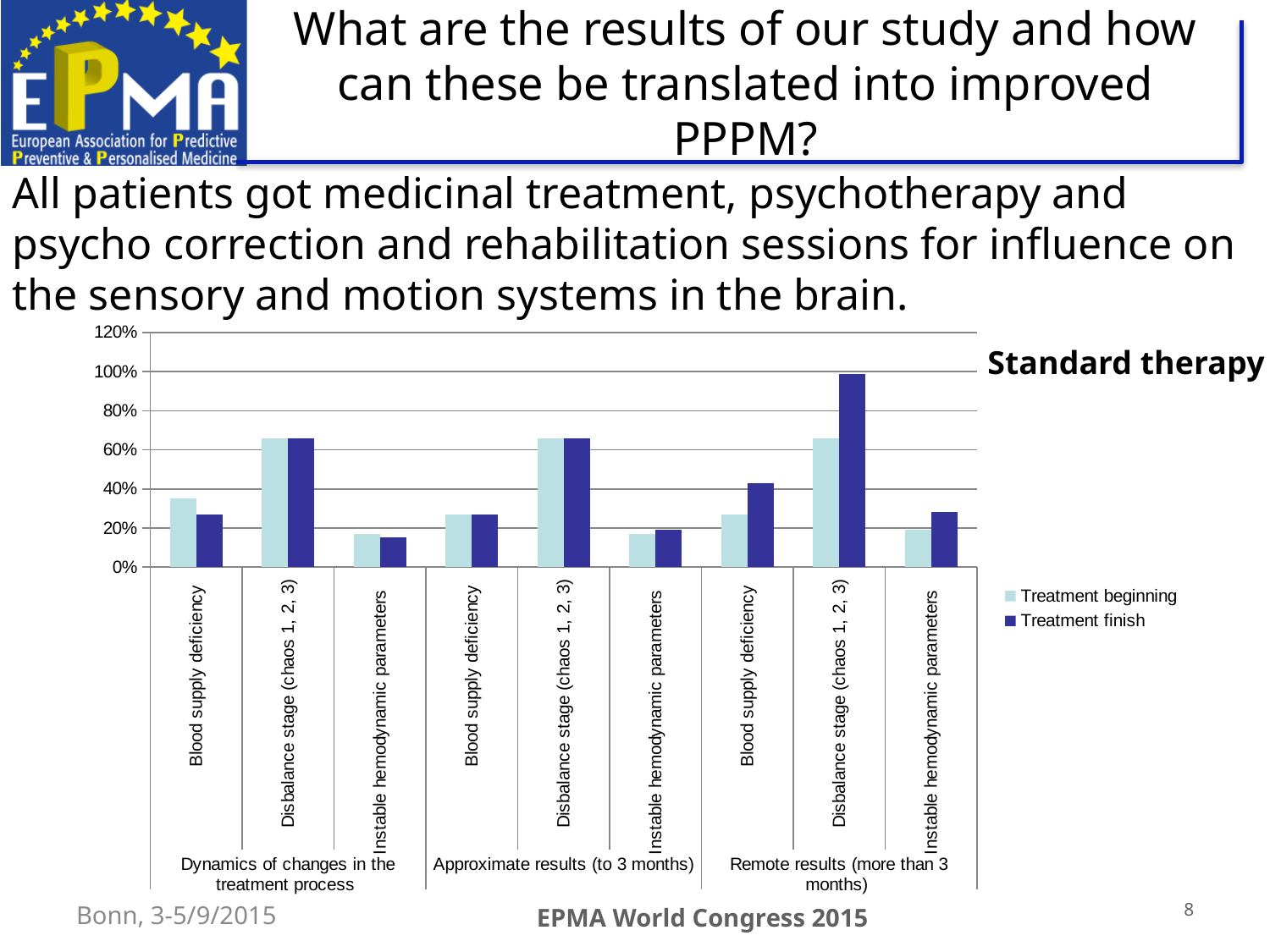
Is the Treatment beginning value for Disbalance stage (chaos 1, 2, 3) under Approximate results (to 3 months) greater or less than 60%? greater Is the Treatment beginning value for Blood supply deficiency under Dynamics of changes in the treatment process greater or less than 40%? less What label appears in bold to the right of the chart, above the legend? Standard therapy How many category bars groups (x-axis categories) are plotted in the chart? 9 Is the Treatment beginning value for Instable hemodynamic parameters under Dynamics of changes in the treatment process greater or less than 20%? less For Blood supply deficiency under Dynamics of changes in the treatment process, which is larger: Treatment beginning or Treatment finish? Treatment beginning How many series does the chart legend list? 2 What are the two series named in the chart legend? Treatment beginning and Treatment finish What kind of chart is shown on the slide? bar chart Which bar in the chart is the highest overall? Treatment finish for Disbalance stage (chaos 1, 2, 3) under Remote results (more than 3 months) For Disbalance stage (chaos 1, 2, 3) under Remote results (more than 3 months), which is larger: Treatment beginning or Treatment finish? Treatment finish